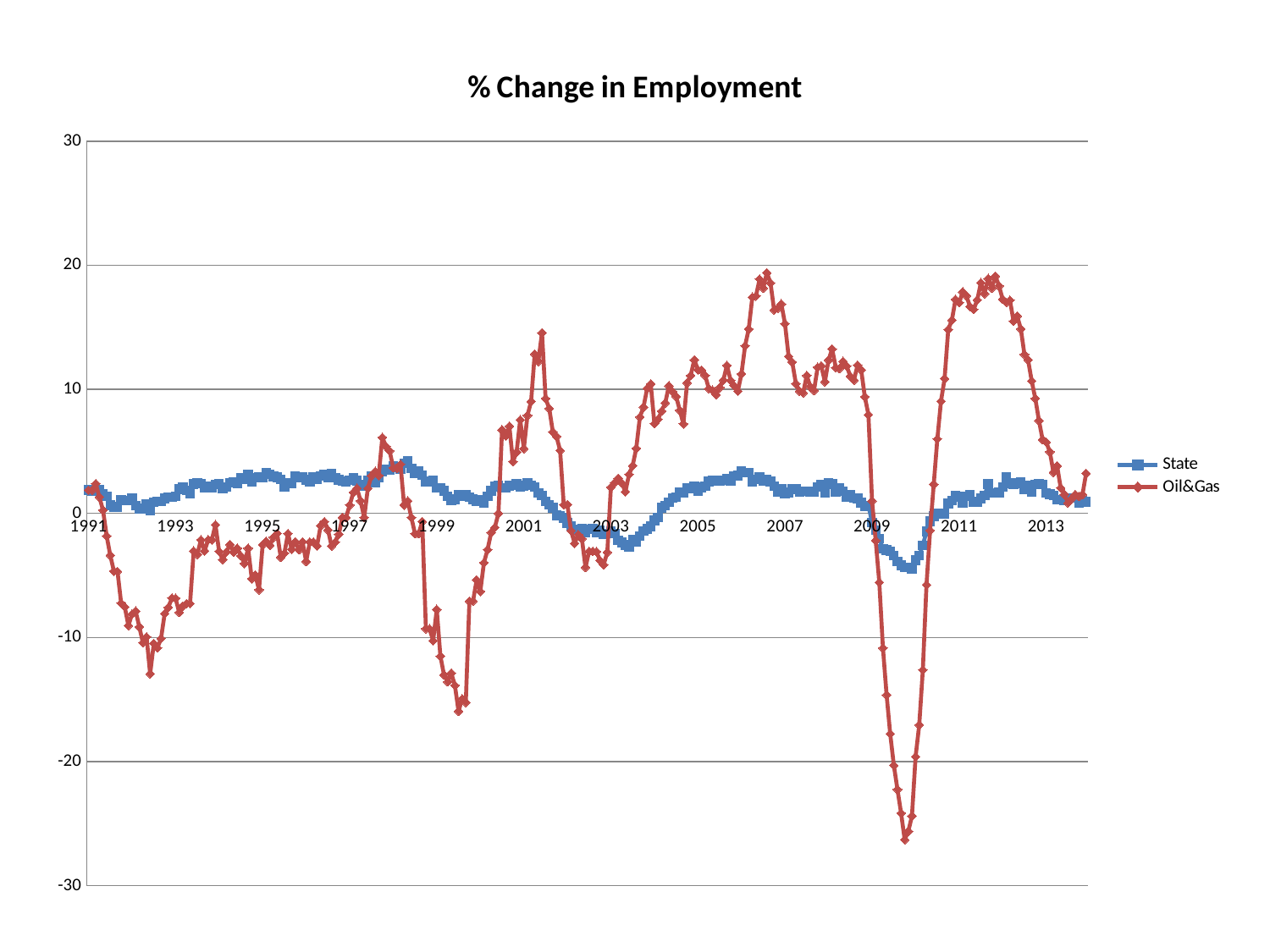
Is the lowest value of the Oil&Gas series, around 2010, greater or less than -20? less What kind of chart is shown on the slide? line chart Which series reaches the lowest value on the chart? Oil&Gas How many year labels are shown on the x axis? 12 Around 2012, which series has the larger value, State or Oil&Gas? Oil&Gas What is the title of the chart? % Change in Employment Does the Oil&Gas series rise or fall between 2012 and 2013? fall How many series does the legend list? 2 Which series reaches the highest value on the chart? Oil&Gas Which colour is used for the Oil&Gas series? red Is the peak value of the Oil&Gas series around 2006-2007 greater or less than 10? greater